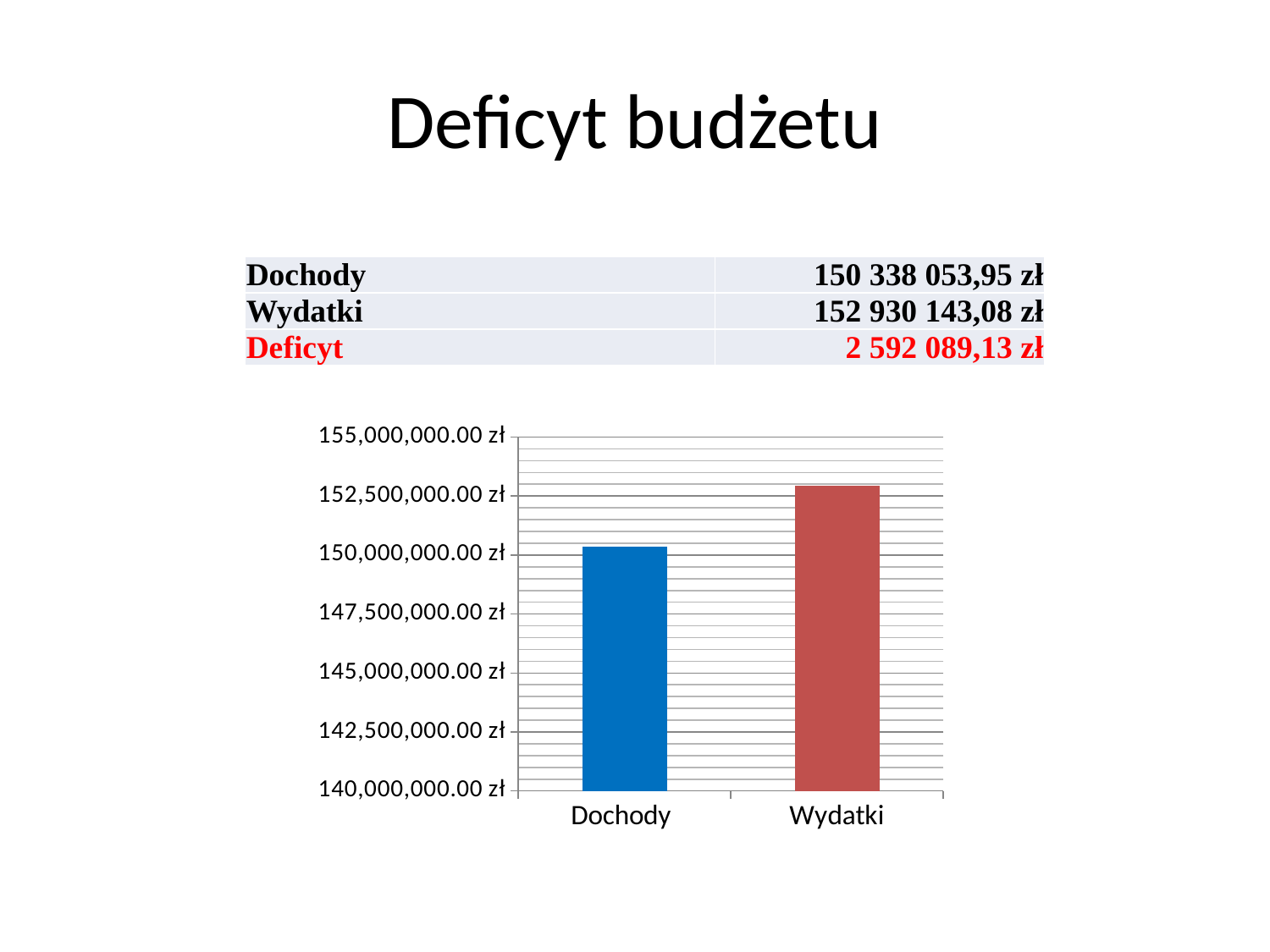
According to the table above the chart, what is the value for Wydatki? 152 930 143,08 zł How many categories are shown on the x axis of the chart? 2 What type of chart is shown on the slide? bar chart Which category has the highest value in the chart? Wydatki Is the value for Dochody greater or less than 150,000,000.00 zł? greater What is the difference between Wydatki and Dochody, as shown in the table as Deficyt? 2 592 089,13 zł Is the value for Wydatki greater or less than 152,500,000.00 zł? greater What colour is the bar for Wydatki? red Which category has the higher bar, Dochody or Wydatki? Wydatki According to the table above the chart, what is the value for Dochody? 150 338 053,95 zł Which category has the lowest value in the chart? Dochody Is the value for Dochody greater or less than 152,500,000.00 zł? less